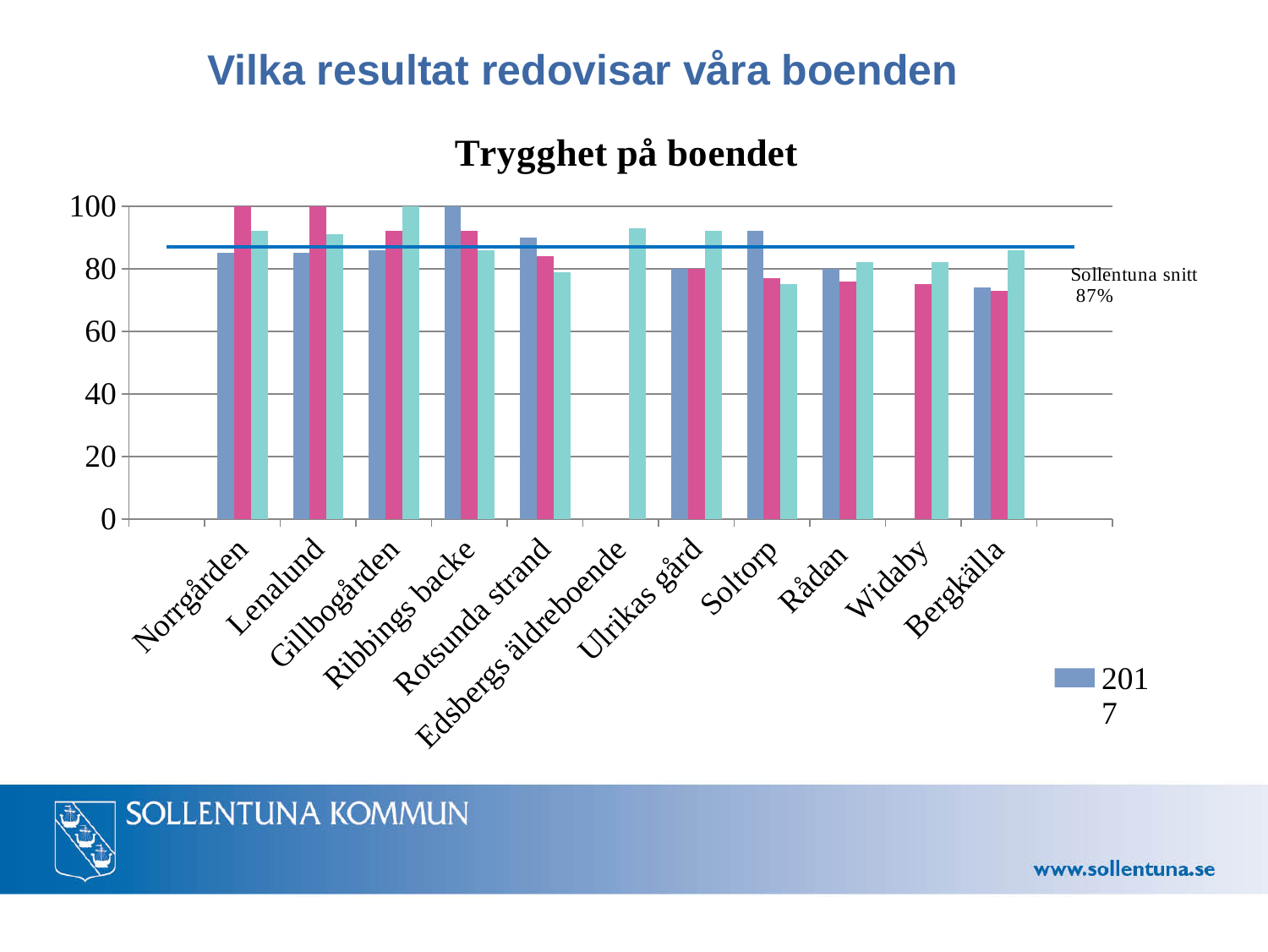
What is the title of the chart? Trygghet på boendet How many residences (categories) are shown on the x axis of the chart? 11 What is the value of the blue bar for Ribbings backe? 100 Which has the larger teal bar, Edsbergs äldreboende or Bergkälla? Edsbergs äldreboende Is the value of the pink bar for Bergkälla greater or less than 80? less What is the value of the teal bar for Gillbogården? 100 What value does the horizontal 'Sollentuna snitt' line on the chart represent? 87% What kind of chart is shown on the slide? bar chart Which has the larger blue bar, Soltorp or Rådan? Soltorp Is the value of the teal bar for Edsbergs äldreboende greater or less than 80? greater Is the value of the pink bar for Widaby greater or less than 80? less What is the value of the pink bar for Norrgården? 100